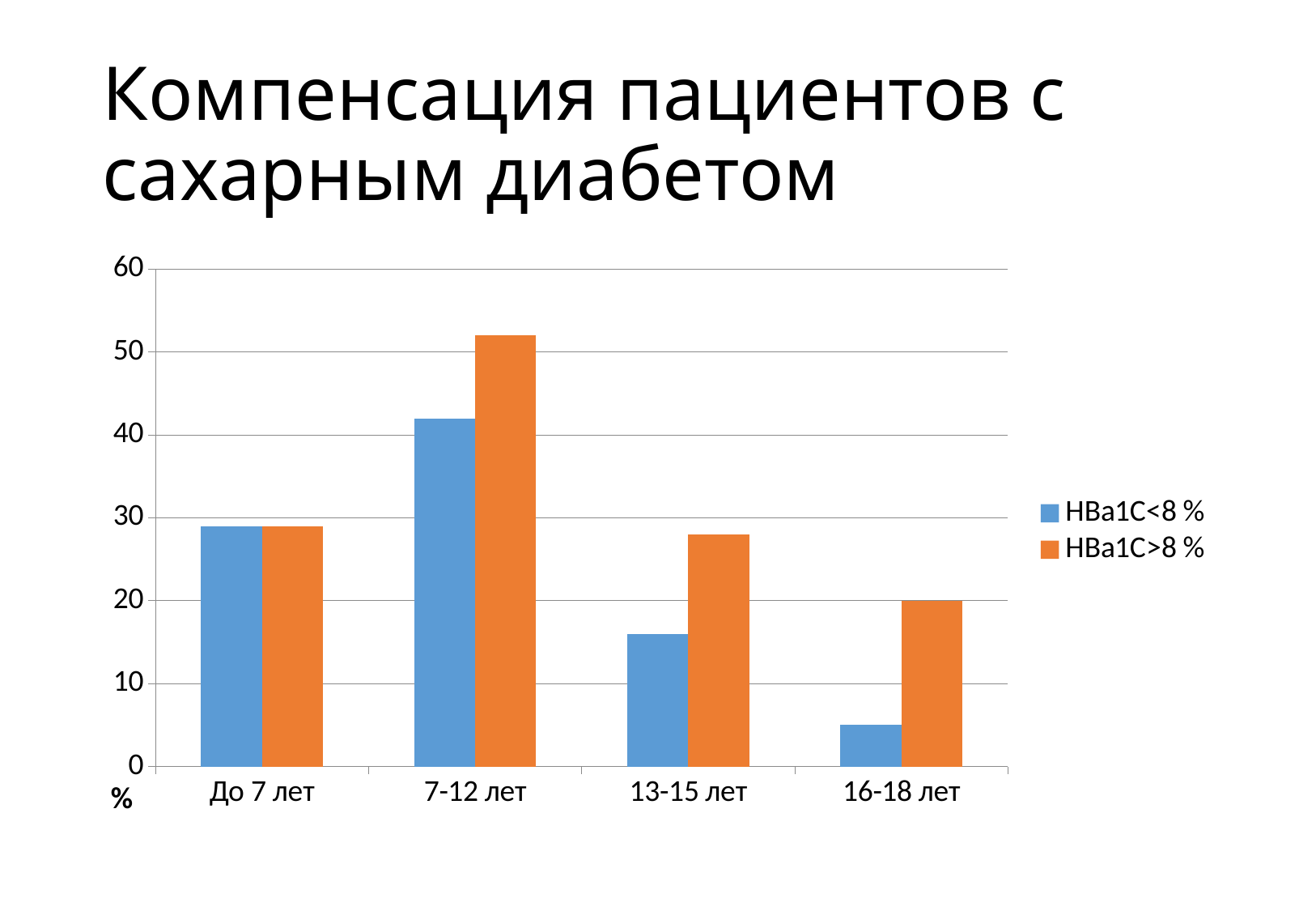
How many age categories are shown on the x axis? 4 How many series does the legend list? 2 Is the value for HBa1C>8 % in the 7-12 лет group greater or less than 50? greater Is the value for HBa1C<8 % in the 16-18 лет group greater or less than 10? less In the 13-15 лет group, which series has the larger value, HBa1C<8 % or HBa1C>8 %? HBa1C>8 % Does the value for HBa1C<8 % rise or fall from the 7-12 лет group to the 16-18 лет group? fall What kind of chart is shown on the slide? bar chart Which age group has the lowest value for HBa1C>8 %? 16-18 лет Is the value for HBa1C<8 % in the 13-15 лет group greater or less than 20? less Which age group has the lowest value for HBa1C<8 %? 16-18 лет Which age group has the highest value for HBa1C>8 %? 7-12 лет What colour are the bars for the HBa1C>8 % series? orange